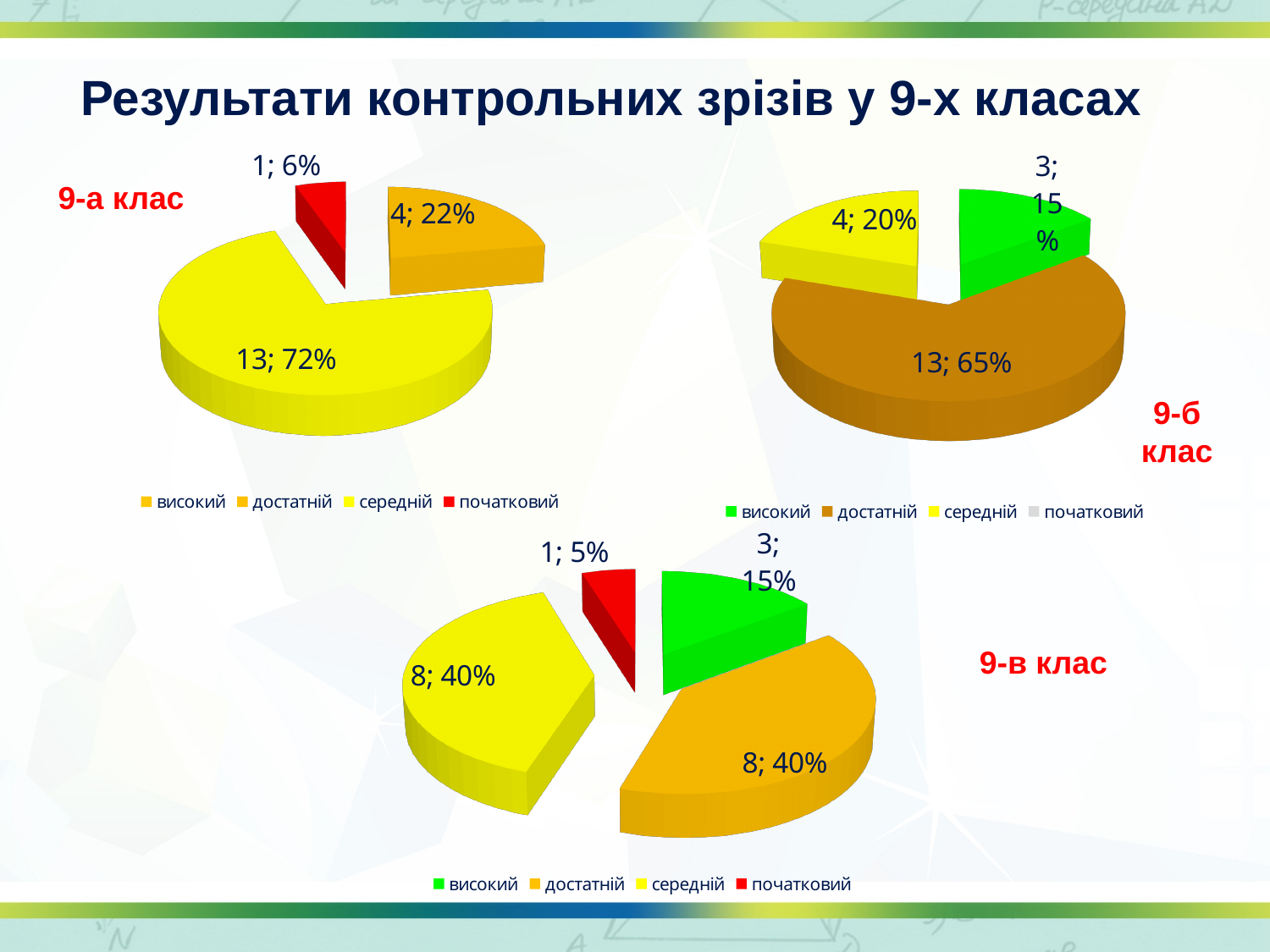
In the 9-в клас chart, what is the difference between the count for середній and the count for високий? 5 In the 9-а клас chart, what share of the pie does the достатній slice have? 22% What type of chart is used for 9-а клас? Pie chart In the 9-б клас chart, what share of the pie does the високий slice have? 15% In the 9-б клас chart, which category has the largest slice? достатній In the 9-б клас chart, what is the data label for the достатній slice? 13; 65% In the 9-а клас chart, what is the data label for the середній slice? 13; 72% In the 9-в клас chart, which is larger, the достатній slice or the високий slice? достатній In the 9-в клас chart, what is the data label for the початковий slice? 1; 5% How many slices are plotted in the 9-в клас chart? 4 How many entries does the legend of the 9-б клас chart list? 4 In the 9-а клас chart, which category has the smallest slice? початковий